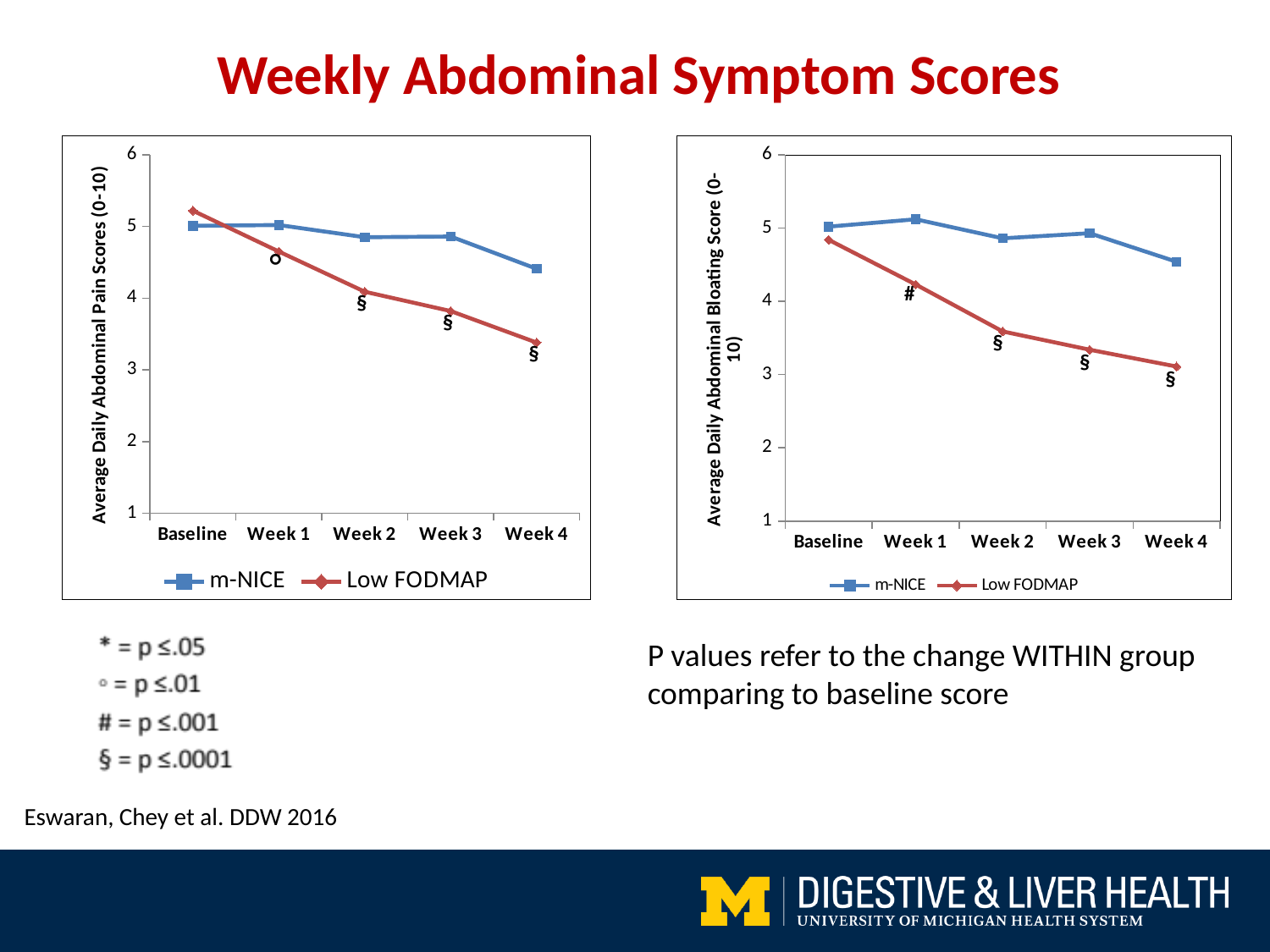
In the left chart (Average Daily Abdominal Pain Scores), is the Low FODMAP value at Week 4 greater or less than 4? less How many series does the legend of the right chart (Average Daily Abdominal Bloating Score) list? 2 In the right chart (Average Daily Abdominal Bloating Score), is the Low FODMAP value at Week 2 greater or less than 4? less What is the y-axis title of the left chart? Average Daily Abdominal Pain Scores (0-10) In the left chart (Average Daily Abdominal Pain Scores), does the Low FODMAP line rise or fall from Baseline to Week 4? fall How many time points are shown on the x axis of the left chart (Average Daily Abdominal Pain Scores)? 5 In the right chart (Average Daily Abdominal Bloating Score), at which time point is the Low FODMAP value lowest? Week 4 In the right chart (Average Daily Abdominal Bloating Score), which group has the higher value at Week 3, m-NICE or Low FODMAP? m-NICE In the right chart (Average Daily Abdominal Bloating Score), does the Low FODMAP line rise or fall from Baseline to Week 4? fall What kind of chart is the left chart (Average Daily Abdominal Pain Scores)? line chart In the left chart (Average Daily Abdominal Pain Scores), is the m-NICE value at Week 4 greater or less than 4? greater In the left chart (Average Daily Abdominal Pain Scores), which group has the higher value at Week 4, m-NICE or Low FODMAP? m-NICE